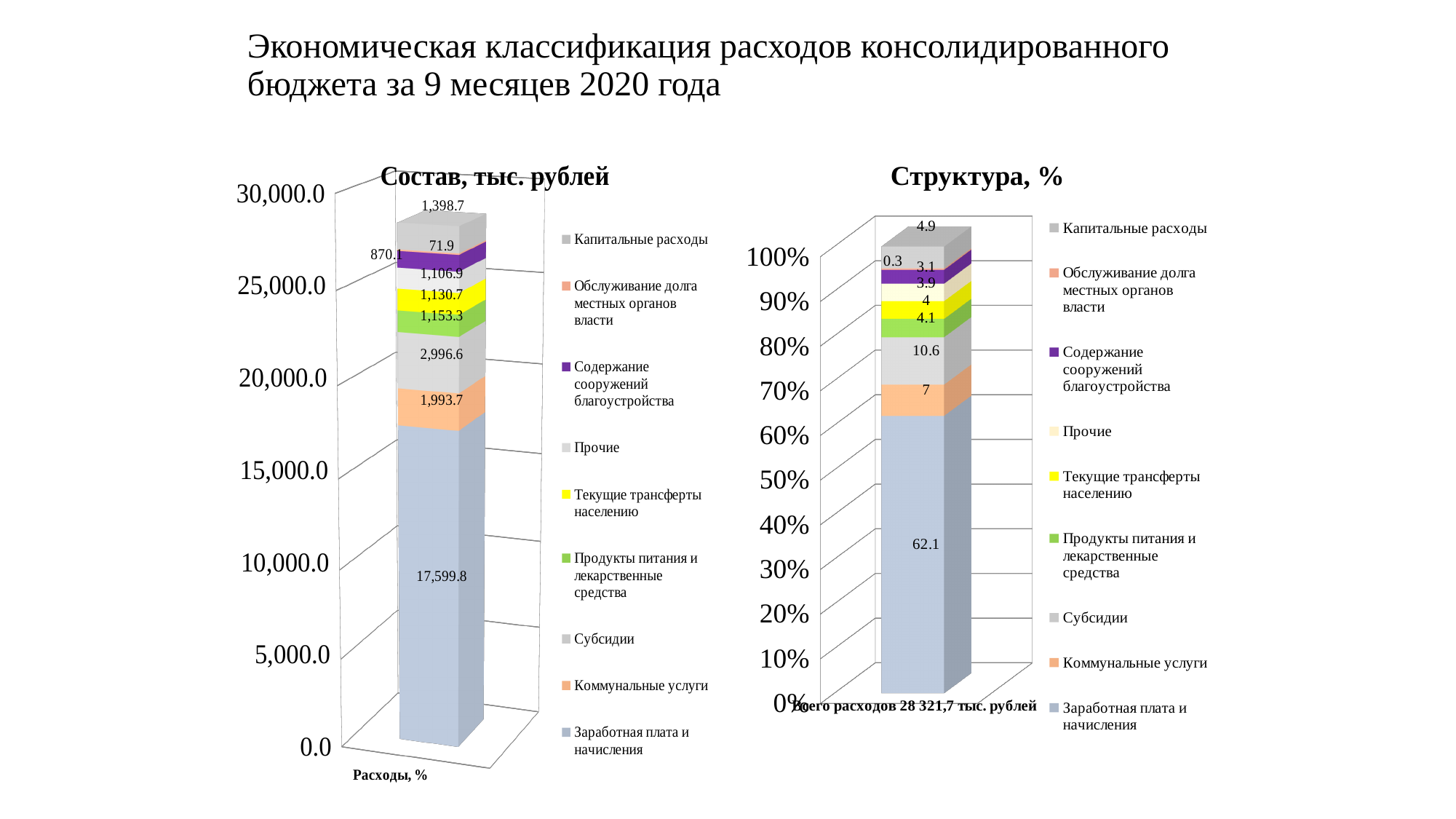
On the chart titled 'Структура, %', what is the share for Коммунальные услуги? 7 On the chart titled 'Структура, %', what is the difference between the shares of Субсидии and Продукты питания и лекарственные средства? 6.5 On the chart titled 'Состав, тыс. рублей', what is the total of the stacked bar? 28,321.7 On the chart titled 'Состав, тыс. рублей', which is larger: Капитальные расходы or Прочие? Капитальные расходы What kind of chart is the chart titled 'Состав, тыс. рублей'? Stacked bar chart On the chart titled 'Структура, %', which category has the largest share? Заработная плата и начисления On the chart titled 'Структура, %', what is the share for Капитальные расходы? 4.9 On the chart titled 'Состав, тыс. рублей', what is the value for Субсидии? 2,996.6 On the chart titled 'Состав, тыс. рублей', which category has the smallest value? Обслуживание долга местных органов власти On the chart titled 'Состав, тыс. рублей', what is the difference between Субсидии and Коммунальные услуги? 1,002.9 How many series does the legend of the chart titled 'Структура, %' list? 9 On the chart titled 'Состав, тыс. рублей', what is the value for Заработная плата и начисления? 17,599.8